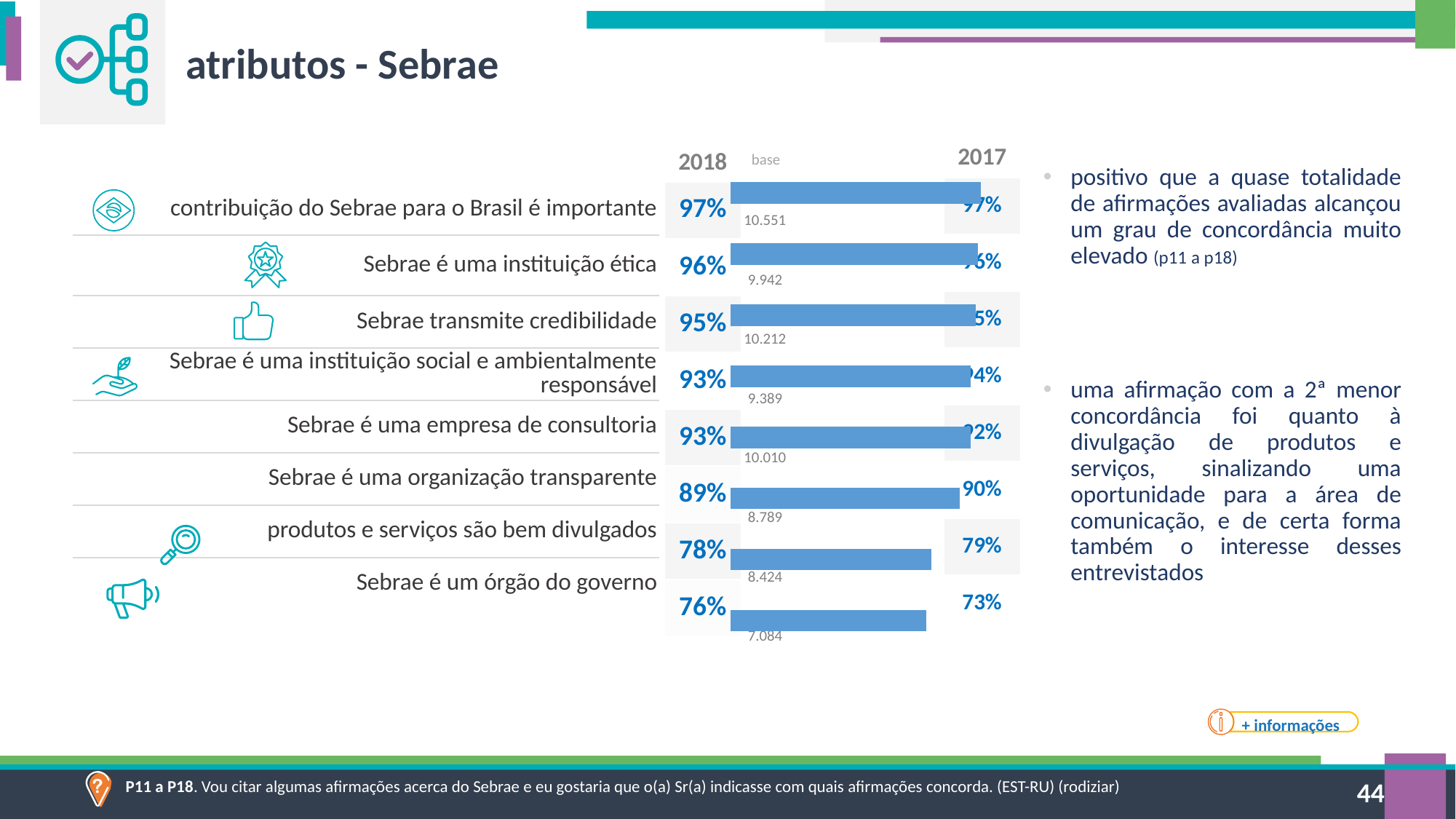
What is the base shown for "Sebrae é um órgão do governo"? 7.084 What kind of chart is used on this slide? bar chart What is the 2018 value for "produtos e serviços são bem divulgados"? 78% What is the 2017 value for "Sebrae é um órgão do governo"? 73% What is the 2018 value for "Sebrae é uma instituição ética"? 96% Which attribute has the highest 2018 value? contribuição do Sebrae para o Brasil é importante Which is larger for "Sebrae é um órgão do governo": the 2018 value or the 2017 value? 2018 How many attributes are shown in the chart? 8 What is the base shown for "contribuição do Sebrae para o Brasil é importante"? 10.551 Which attribute has the lowest 2018 value? Sebrae é um órgão do governo What is the 2017 value for "Sebrae é uma organização transparente"? 90% What is the difference between the 2018 values for "Sebrae transmite credibilidade" and "Sebrae é um órgão do governo"? 19%